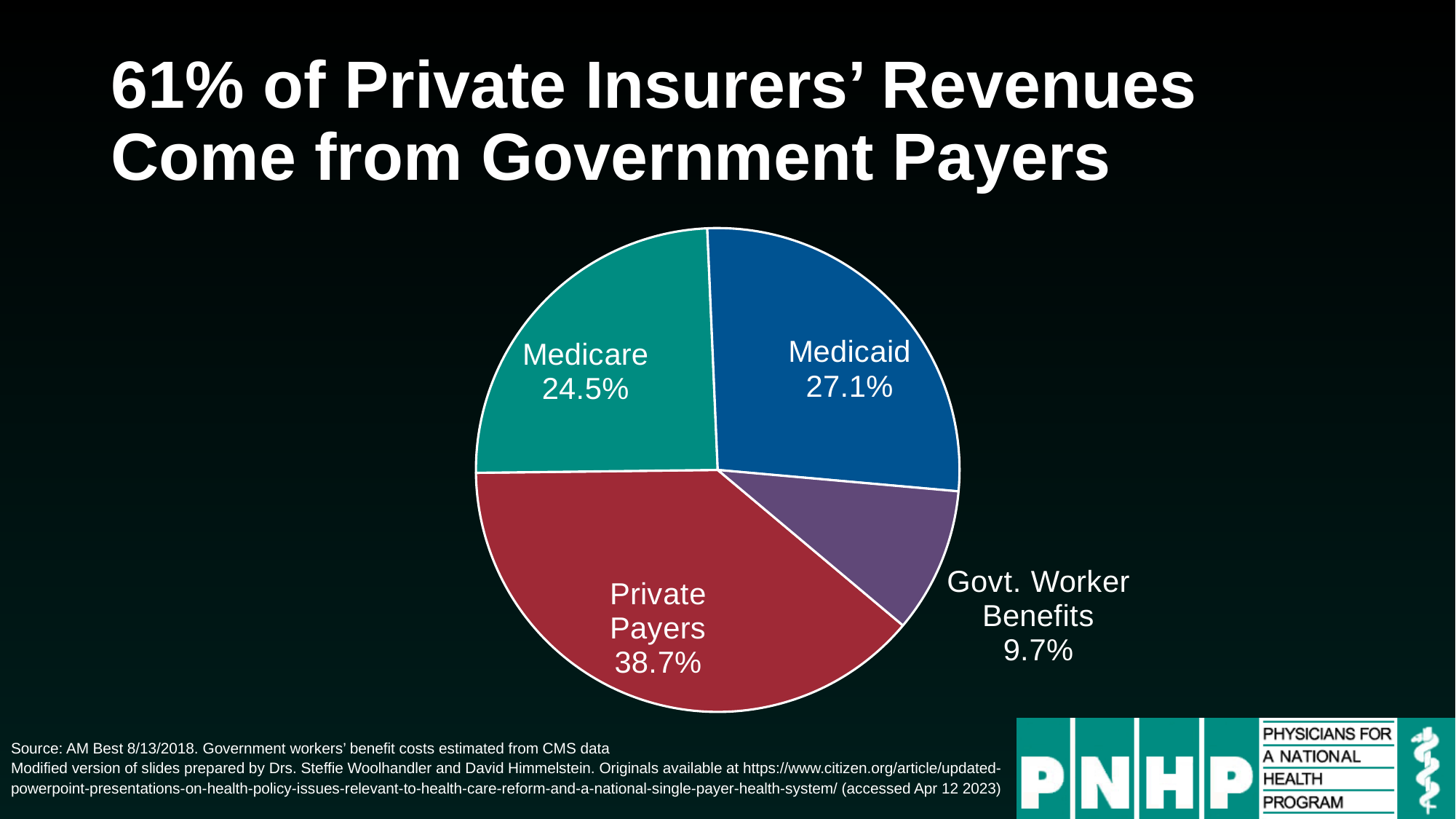
What share of private insurers' revenues comes from Govt. Worker Benefits? 9.7% Which slice of the pie is the smallest? Govt. Worker Benefits How many slices does the pie chart have? 4 What is the title of the slide? 61% of Private Insurers' Revenues Come from Government Payers What kind of chart is shown on the slide? Pie chart What share of private insurers' revenues comes from Private Payers? 38.7% What share of private insurers' revenues comes from Medicaid? 27.1% What is the difference in percentage points between Private Payers and Govt. Worker Benefits? 29 Which slice of the pie is the largest? Private Payers Which is larger, the Medicaid slice or the Medicare slice? Medicaid What is the difference in percentage points between the Medicaid and Medicare slices? 2.6 What share of private insurers' revenues comes from Medicare? 24.5%